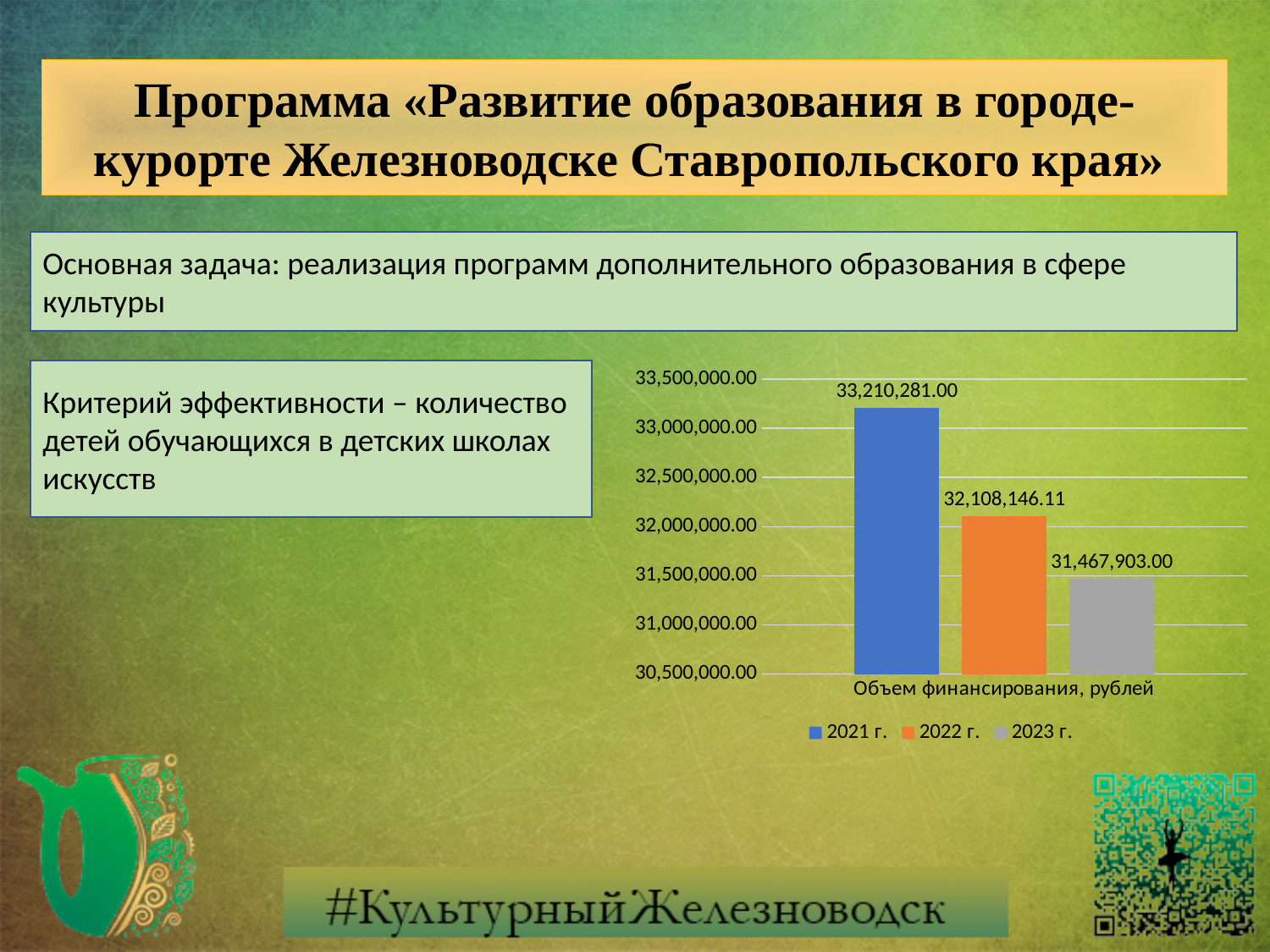
Which is larger, the value for 2021 г. or the value for 2023 г.? 2021 г. What kind of chart is shown on the slide? bar chart What is the difference between the 2022 г. and 2023 г. values? 640,243.11 How many series does the legend list? 3 What is the value for 2023 г. in the chart? 31,467,903.00 Which year has the lowest funding value in the chart? 2023 г. Is the value for 2023 г. greater or less than 31,500,000.00? less What is the value for 2022 г. in the chart? 32,108,146.11 What is the difference between the 2021 г. and 2022 г. values? 1,102,134.89 What is the value for 2021 г. in the chart? 33,210,281.00 What is the category label shown on the x axis of the chart? Объем финансирования, рублей Which year has the highest funding value in the chart? 2021 г.